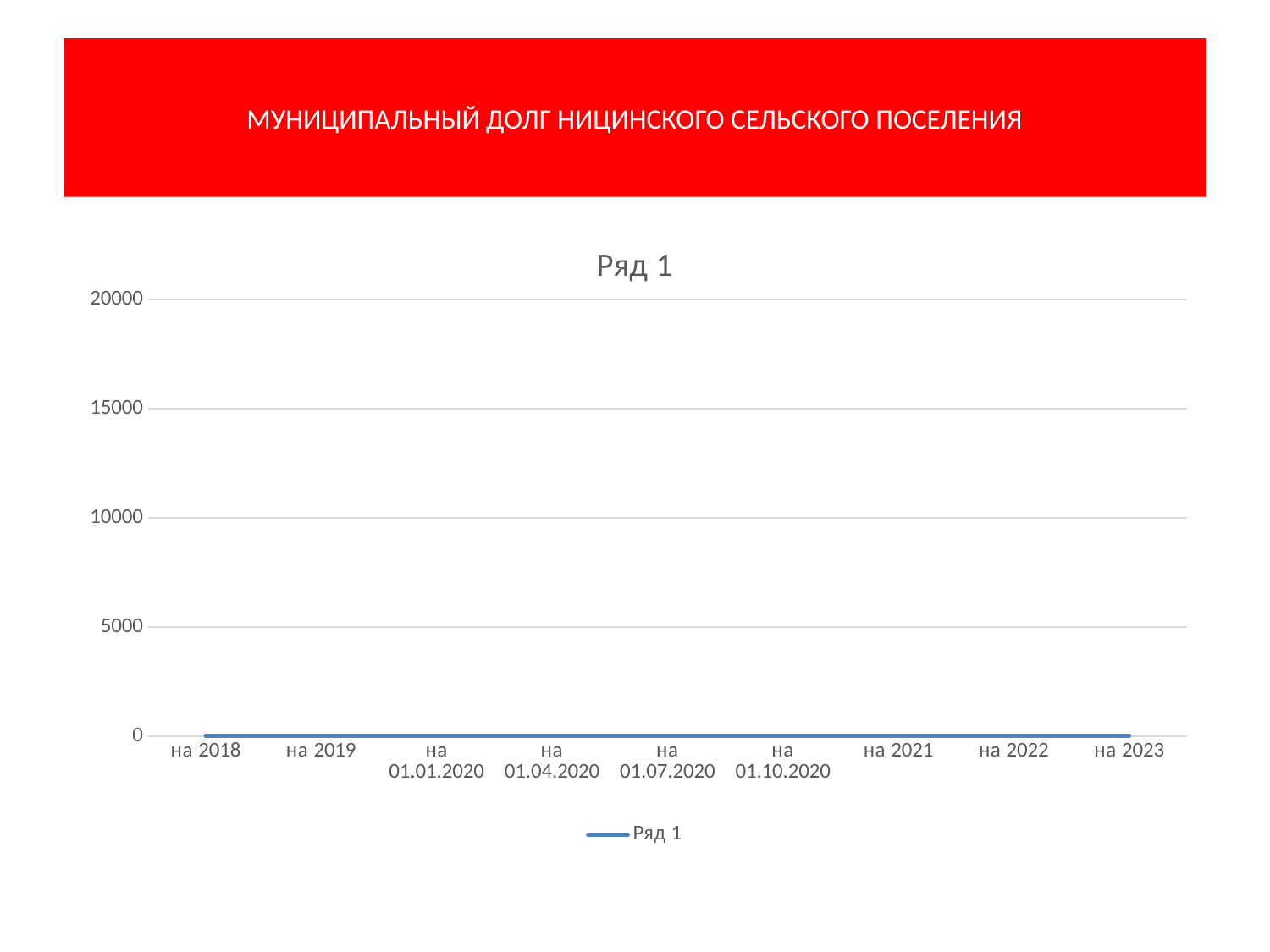
What is the title of the chart? Ряд 1 What kind of chart is shown on the slide? line chart What is the highest value shown on the y axis of the chart? 20000 What is the name of the series listed in the chart legend? Ряд 1 How many categories are shown on the x axis of the chart? 9 Is the value for 'на 2021' greater or less than 5000? less What is the value for 'на 2023' in the chart? 0 What is the value for 'на 2018' in the chart? 0 What is the value for 'на 01.07.2020' in the chart? 0 Do the values rise, fall, or stay flat along the x axis of the chart? stay flat What is the difference between the values for 'на 2019' and 'на 2022'? 0 How many series does the chart legend list? 1